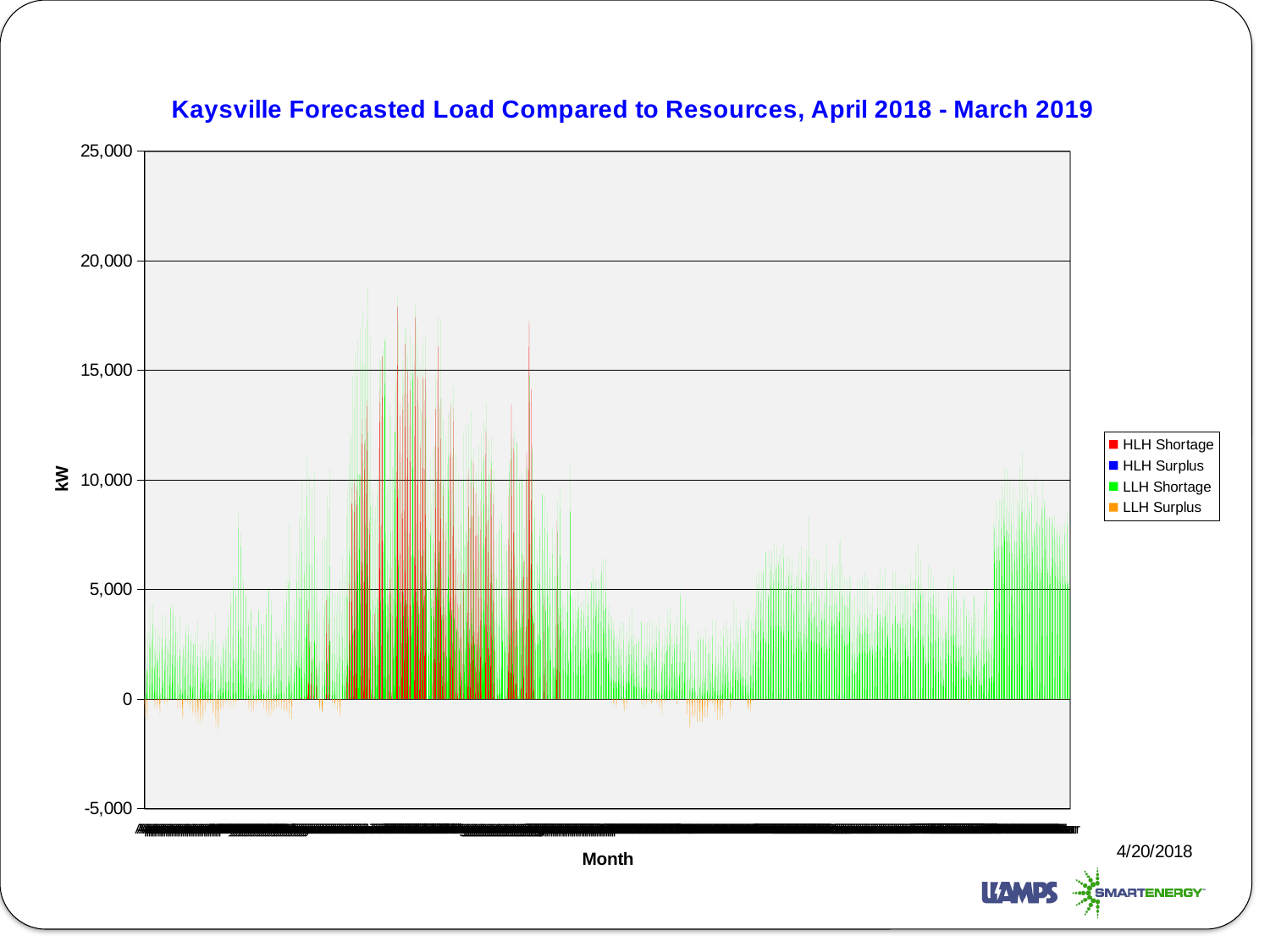
What is the title of the chart? Kaysville Forecasted Load Compared to Resources, April 2018 - March 2019 What is the label on the vertical axis? kW What kind of chart is shown on the slide? bar chart Which series is shown in orange in the legend? LLH Surplus How many series does the legend list? 4 Is the tallest bar on the chart greater or less than 15,000? greater Is the tallest bar on the chart greater or less than 20,000? less